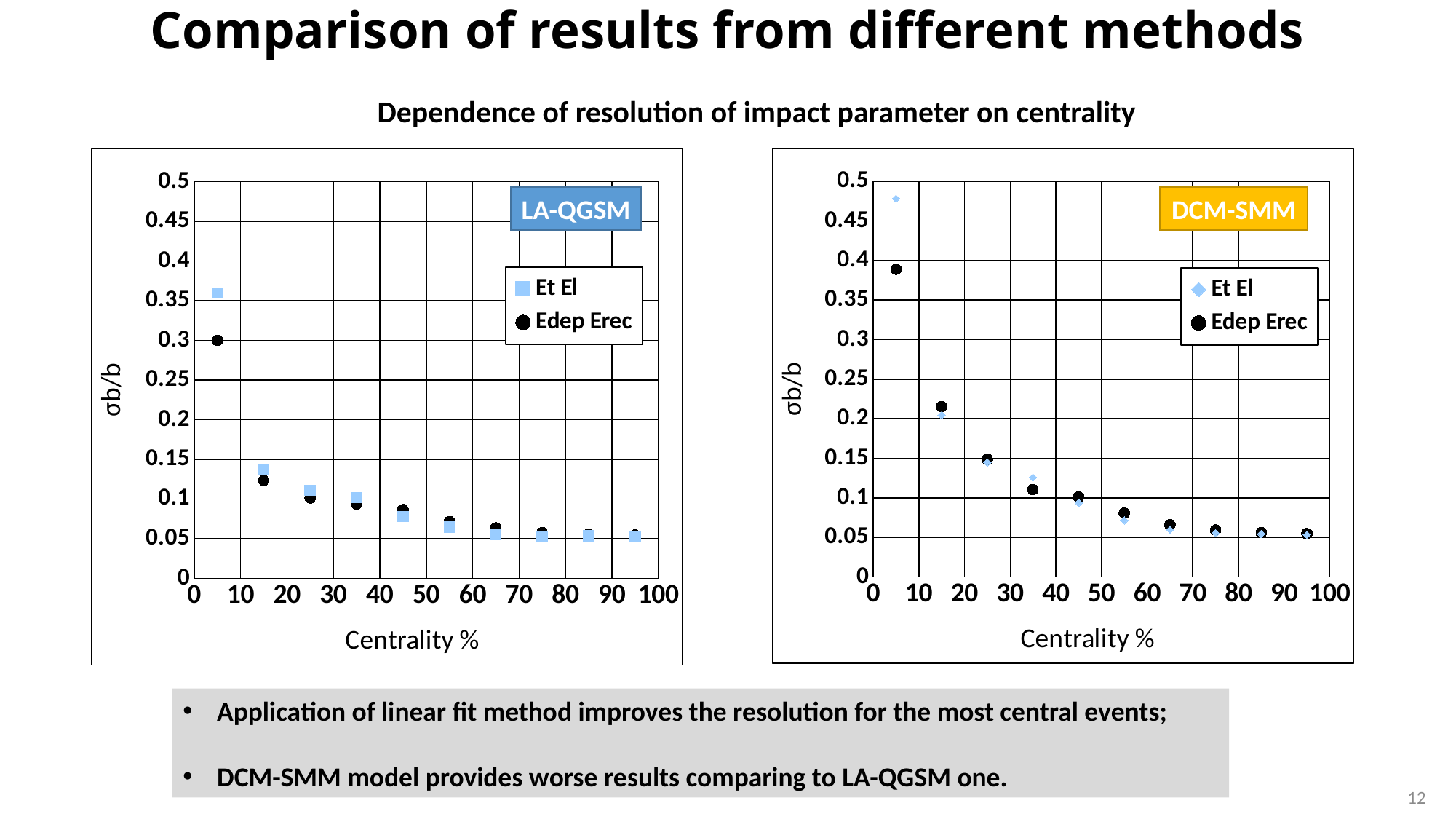
In the DCM-SMM chart, at which centrality is the Edep Erec value highest? 5 What kind of chart is the LA-QGSM chart? scatter chart What is the label of the y axis on the LA-QGSM chart? σb/b In the LA-QGSM chart, is the Et El value at centrality 5 greater or less than 0.3? greater In the LA-QGSM chart, is the Edep Erec value at centrality 95 greater or less than 0.1? less In the DCM-SMM chart, at centrality 5, which series has the larger value, Et El or Edep Erec? Et El In the DCM-SMM chart, is the Edep Erec value at centrality 5 greater or less than 0.35? greater How many series does the legend of the DCM-SMM chart list? 2 In the LA-QGSM chart, how many data points are plotted for the Edep Erec series? 10 In the LA-QGSM chart, at which centrality is the Et El value highest? 5 In the DCM-SMM chart, do the Et El values rise or fall as centrality increases? fall